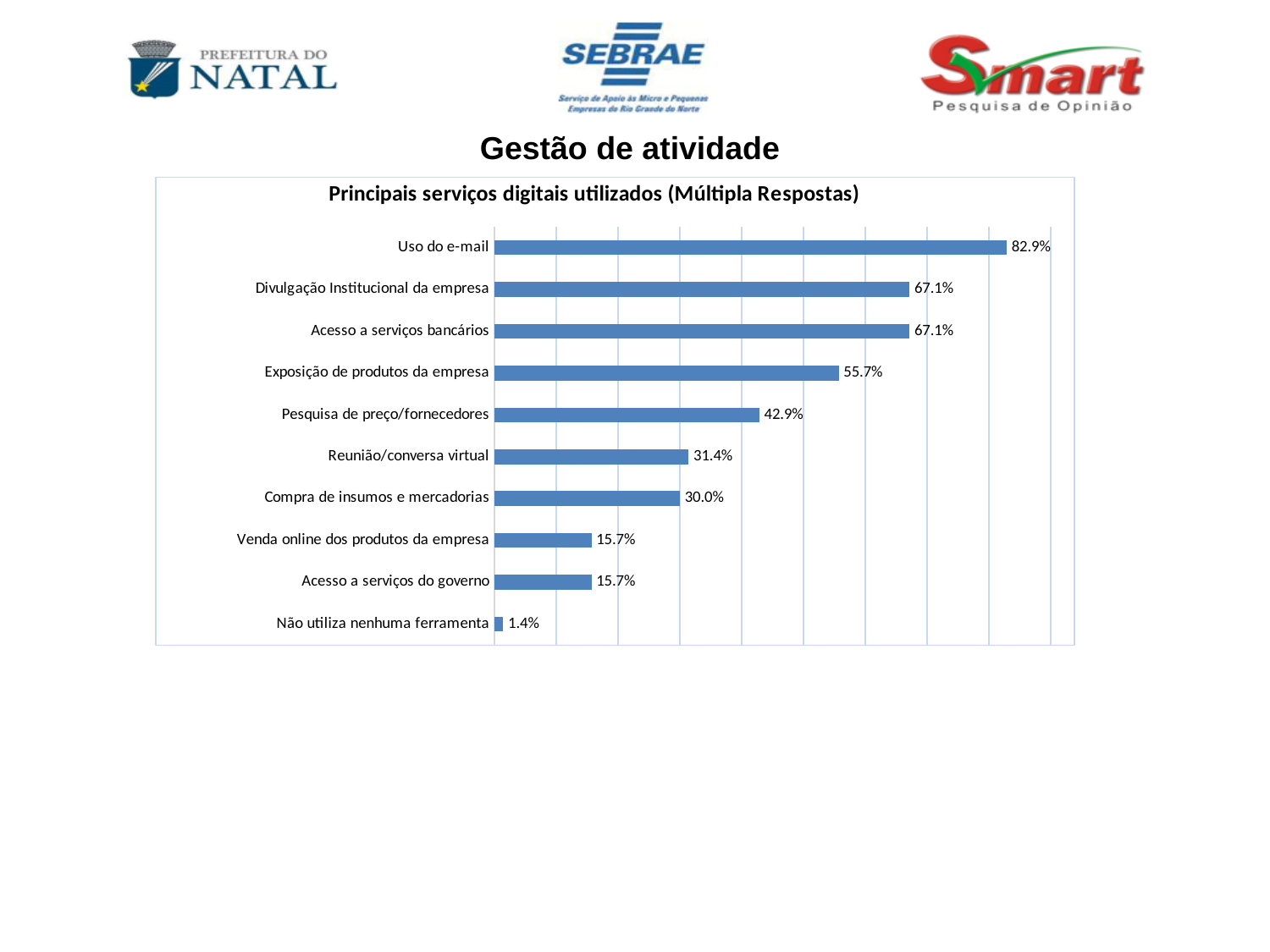
What is the value for Pesquisa de preço/fornecedores? 42.9% Which category has the lowest value? Não utiliza nenhuma ferramenta What is the value for Acesso a serviços do governo? 15.7% Which is larger, Exposição de produtos da empresa or Pesquisa de preço/fornecedores? Exposição de produtos da empresa What is the difference between Uso do e-mail and Divulgação Institucional da empresa? 15.8% What is the title of the chart? Principais serviços digitais utilizados (Múltipla Respostas) What is the value for Uso do e-mail? 82.9% What kind of chart is this? Bar chart What is the value for Compra de insumos e mercadorias? 30.0% Which category has the highest value? Uso do e-mail How many categories are shown in the chart? 10 What is the difference between Exposição de produtos da empresa and Reunião/conversa virtual? 24.3%